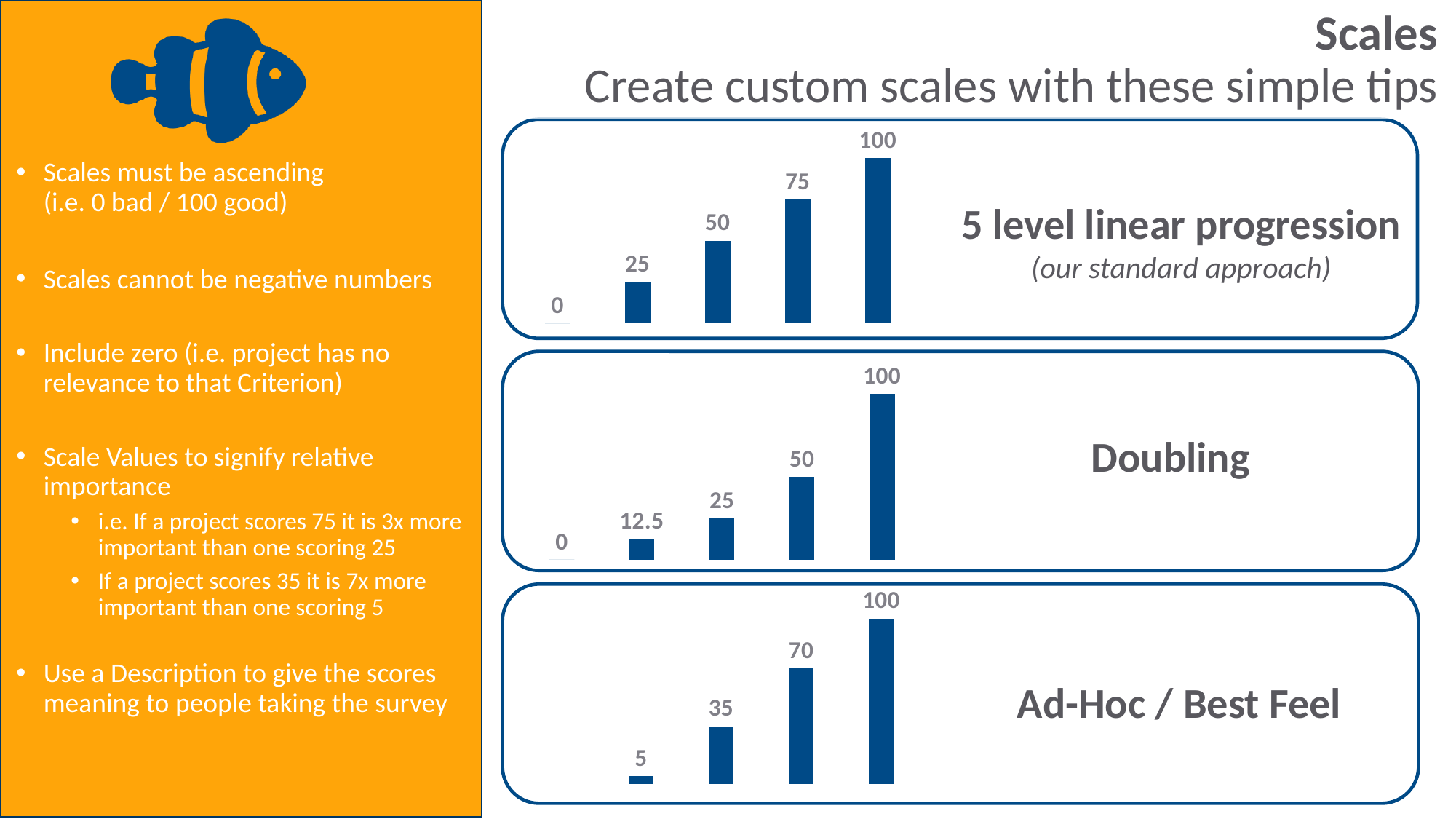
In the 'Ad-Hoc / Best Feel' chart, how many bars are plotted? 4 In the 'Doubling' chart, what is the highest value shown? 100 In the 'Doubling' chart, do the values rise or fall from left to right? Rise In the 'Ad-Hoc / Best Feel' chart, what is the value of the third bar from the left? 70 What type of chart is the 'Doubling' chart? Bar chart In the 'Doubling' chart, what is the difference between the third bar (25) and the fourth bar (50)? 25 In the 'Ad-Hoc / Best Feel' chart, what is the difference between the second bar (35) and the third bar (70)? 35 In the '5 level linear progression' chart, how many data points (including the 0) are labelled? 5 In the 'Ad-Hoc / Best Feel' chart, what is the value of the smallest bar? 5